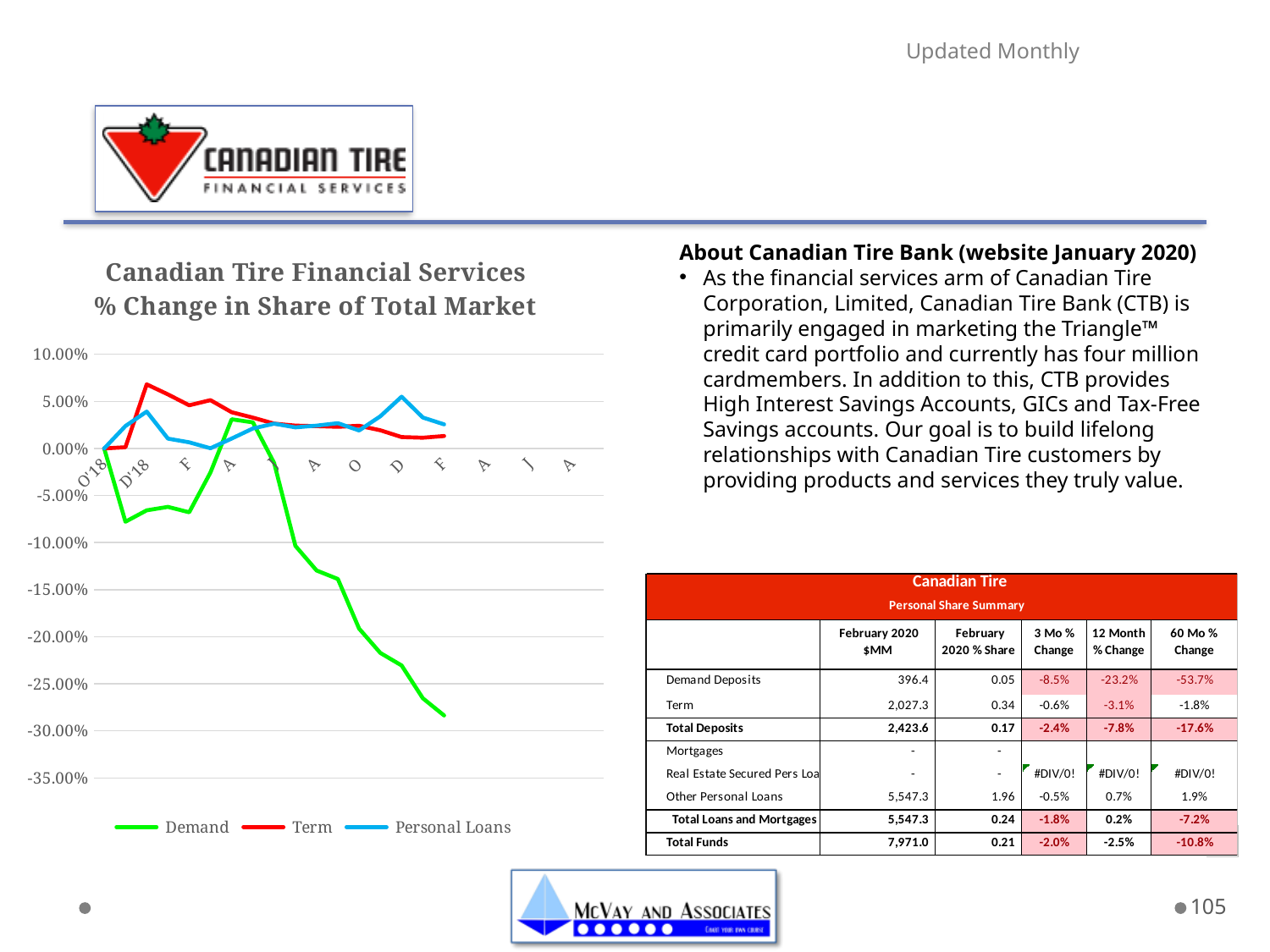
What colour is the Demand line in the chart? green Is the final plotted value of the Demand series greater or less than -25.00%? less How many category labels are shown along the x axis of the chart? 12 What kind of chart is shown on the slide? line chart Is the value of the Demand series at D'18 greater or less than -5.00%? less What are the three series named in the chart legend? Demand, Term, Personal Loans At the last plotted point, which series is higher: Term or Personal Loans? Personal Loans How many series does the chart legend list? 3 Which series has the lowest value at the last plotted point on the chart? Demand Is the value of the Term series at D'18 greater or less than 5.00%? greater At D'18, which series is higher: Term or Demand? Term Does the Demand series rise or fall overall from left to right across the chart? fall